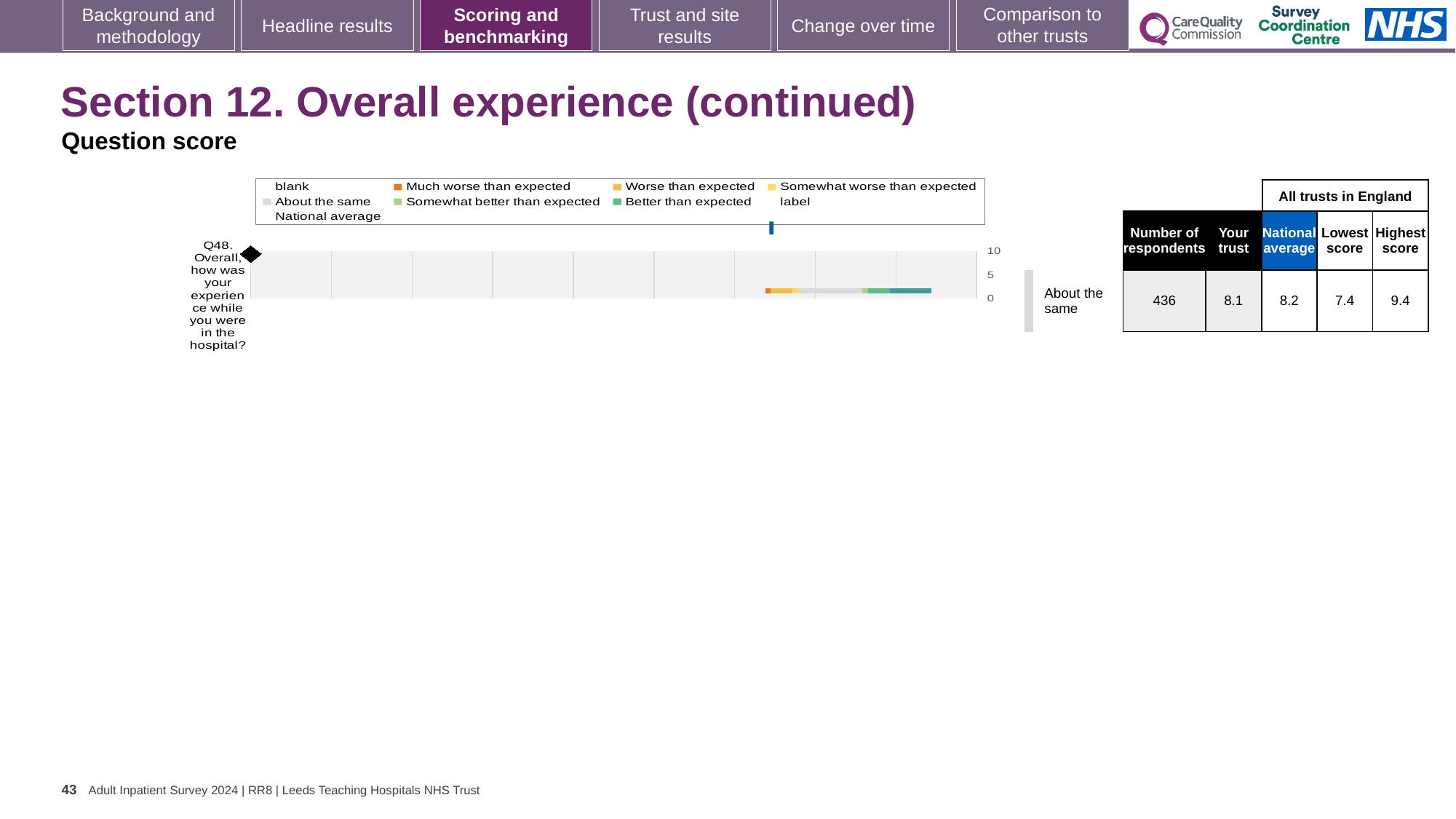
How many respondents answered Q48? 436 What is the benchmark category shown next to the chart for Q48? About the same How many questions (categories) are plotted in the chart? 1 What is the 'Your trust' score for Q48? 8.1 What is the difference between the Highest score and the Lowest score for Q48? 2.0 What is the Highest score among all trusts in England for Q48? 9.4 What is the highest value shown on the chart's axis? 10 What is the National average score for Q48? 8.2 Which is larger for Q48, the 'Your trust' score or the National average? National average What kind of chart is shown on the slide? bar chart What is the Lowest score among all trusts in England for Q48? 7.4 Which question is plotted in the chart? Q48. Overall, how was your experience while you were in the hospital?